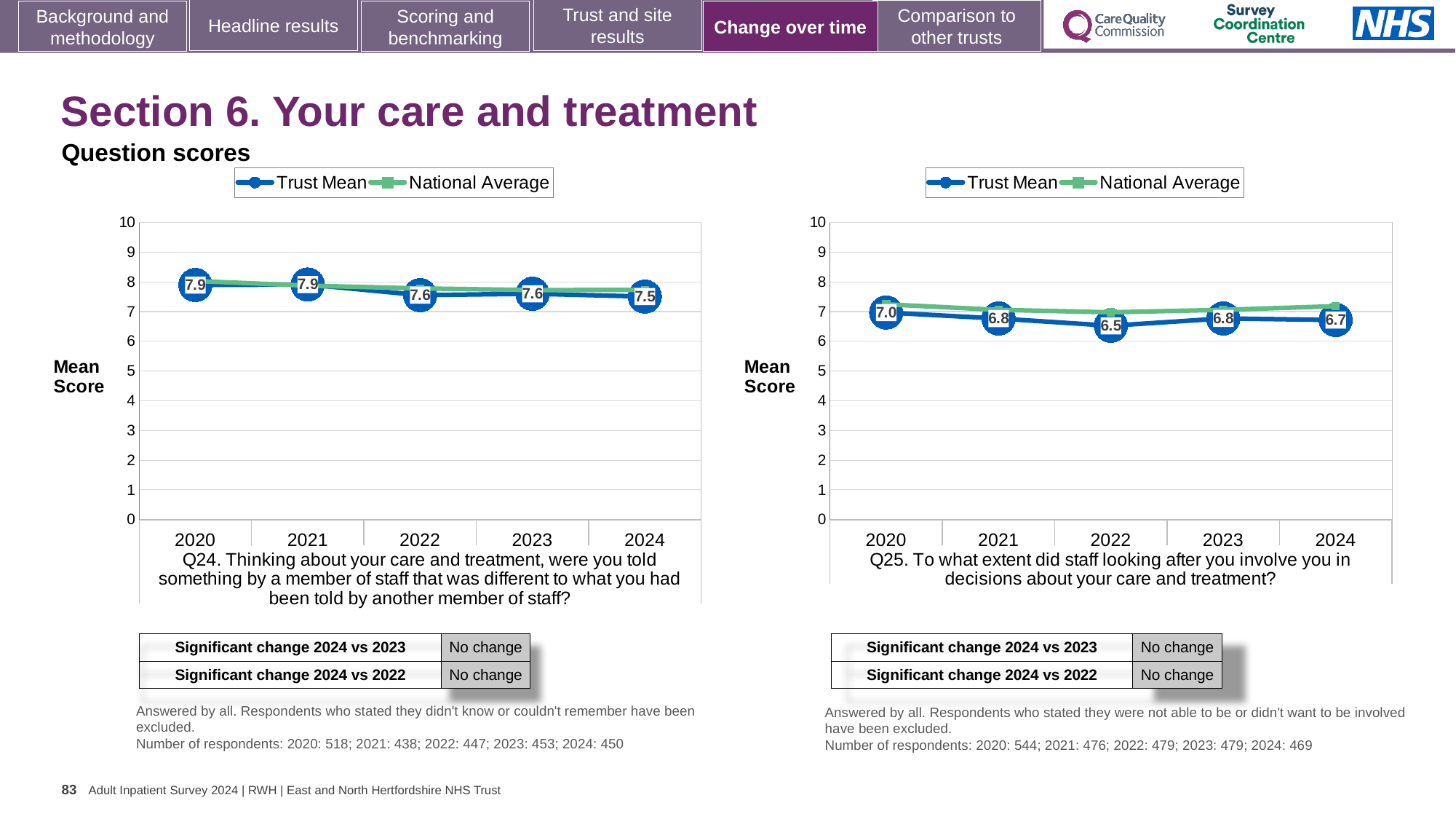
On the Q25 chart, what is the Trust Mean score for 2022? 6.5 On the Q25 chart, what is the Trust Mean score for 2020? 7.0 How many series does the legend of the Q25 chart list? 2 On the Q25 chart, what is the difference between the Trust Mean score in 2020 and in 2022? 0.5 On the Q25 chart, is the Trust Mean score for 2023 greater or less than 6? greater How many years are plotted on the Q24 chart? 5 On the Q24 chart, what is the Trust Mean score for 2020? 7.9 On the Q24 chart, is the Trust Mean score for 2022 greater or less than 8? less On the Q25 chart, which year has the lowest Trust Mean score? 2022 What kind of chart is the Q24 chart? Line chart On the Q24 chart, what is the difference between the Trust Mean score in 2020 and in 2024? 0.4 On the Q24 chart, what is the Trust Mean score for 2024? 7.5